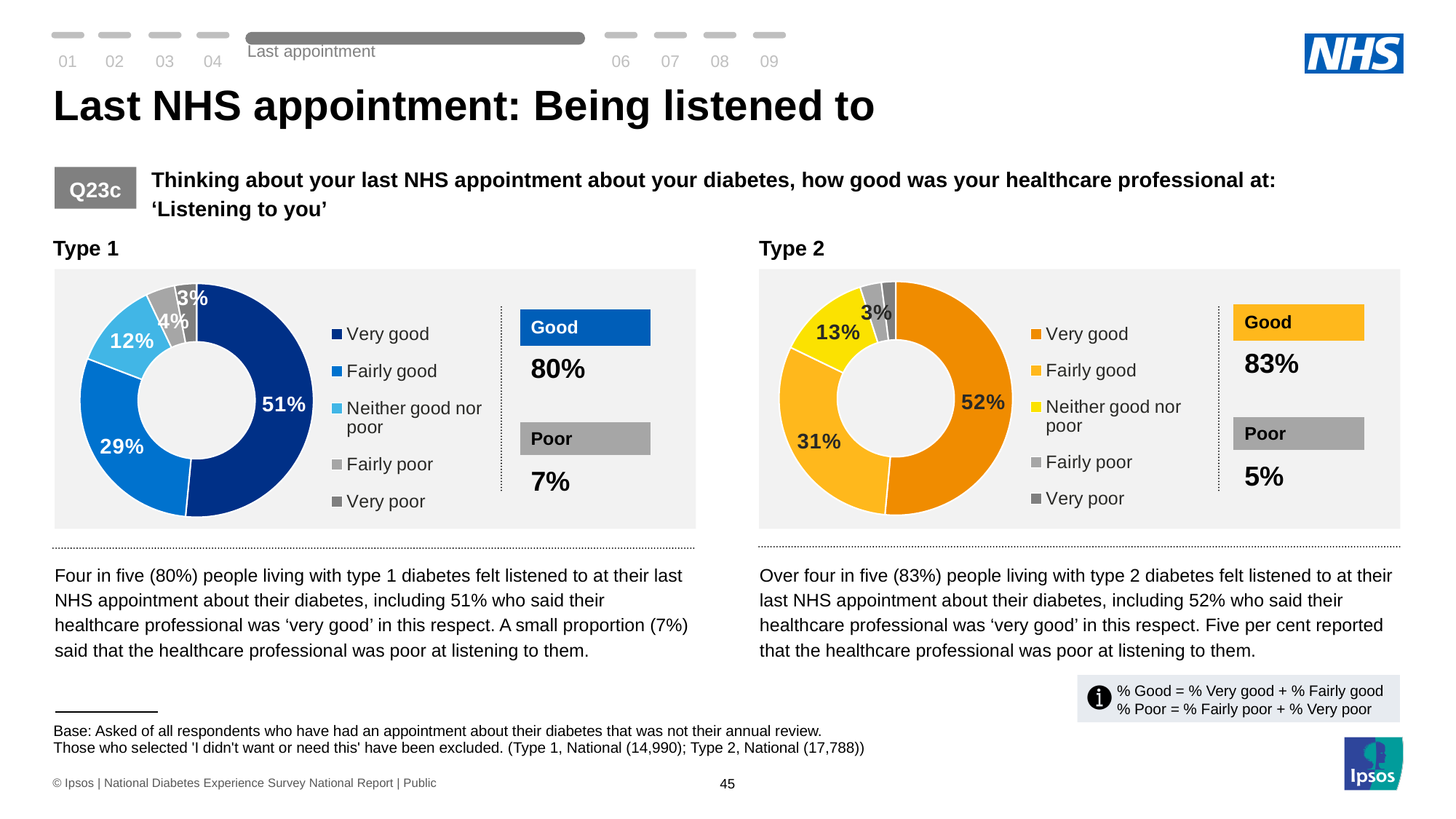
In the Type 1 chart, what is the difference between the 'Very good' and 'Fairly good' percentages? 22 percentage points How many response categories does the legend of the Type 2 chart list? 5 In the Type 2 chart, what percentage selected 'Neither good nor poor'? 13% What kind of chart is used to show the Type 1 results? Donut (pie) chart Which is larger: the 'Very good' share in the Type 1 chart or the 'Very good' share in the Type 2 chart? Type 2 In the Type 1 chart, which response category has the largest share? Very good In the Type 1 chart, what percentage of respondents said their healthcare professional was 'Very good' at listening to them? 51% In the Type 1 chart, what percentage selected 'Neither good nor poor'? 12% What is the combined 'Poor' percentage shown next to the Type 1 chart? 7% In the Type 2 chart, what percentage of respondents said their healthcare professional was 'Fairly good' at listening to them? 31% What is the combined 'Good' percentage shown next to the Type 2 chart? 83% In the Type 1 chart, which response category has the smallest share? Very poor